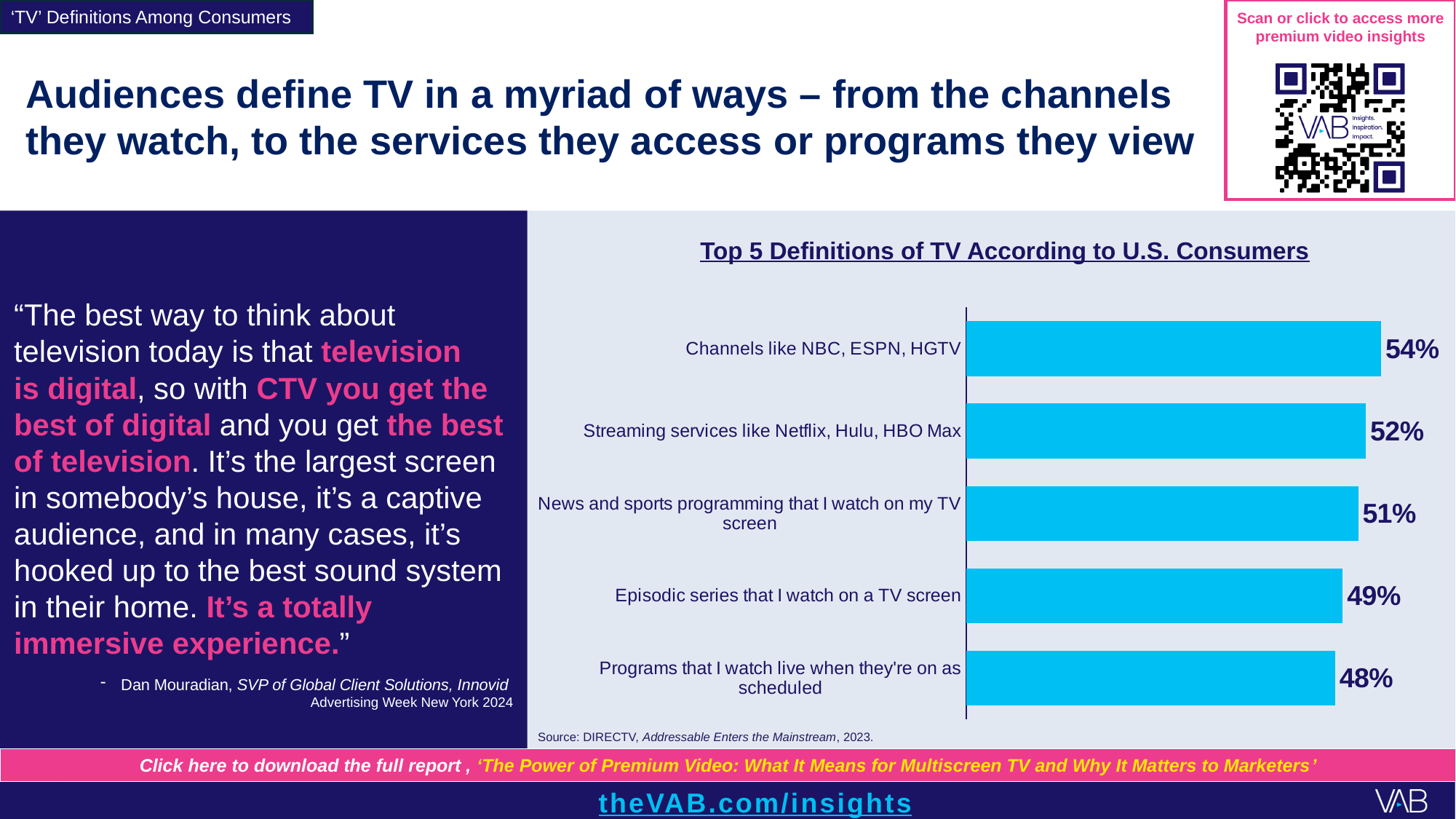
How many definitions of TV are shown in the chart? 5 What is the value for 'Streaming services like Netflix, Hulu, HBO Max'? 52% What is the title of the chart? Top 5 Definitions of TV According to U.S. Consumers What is the value for 'Episodic series that I watch on a TV screen'? 49% Which definition of TV has the lowest percentage? Programs that I watch live when they're on as scheduled What is the difference between the values for 'Channels like NBC, ESPN, HGTV' and 'Programs that I watch live when they're on as scheduled'? 6% What kind of chart is used to show the Top 5 Definitions of TV? Bar chart Which definition of TV has the highest percentage? Channels like NBC, ESPN, HGTV What is the source cited for the chart data? DIRECTV, Addressable Enters the Mainstream, 2023 What percentage of U.S. consumers define TV as 'Channels like NBC, ESPN, HGTV'? 54% What is the value for 'Programs that I watch live when they're on as scheduled'? 48% Which is larger: the value for 'News and sports programming that I watch on my TV screen' or 'Episodic series that I watch on a TV screen'? News and sports programming that I watch on my TV screen